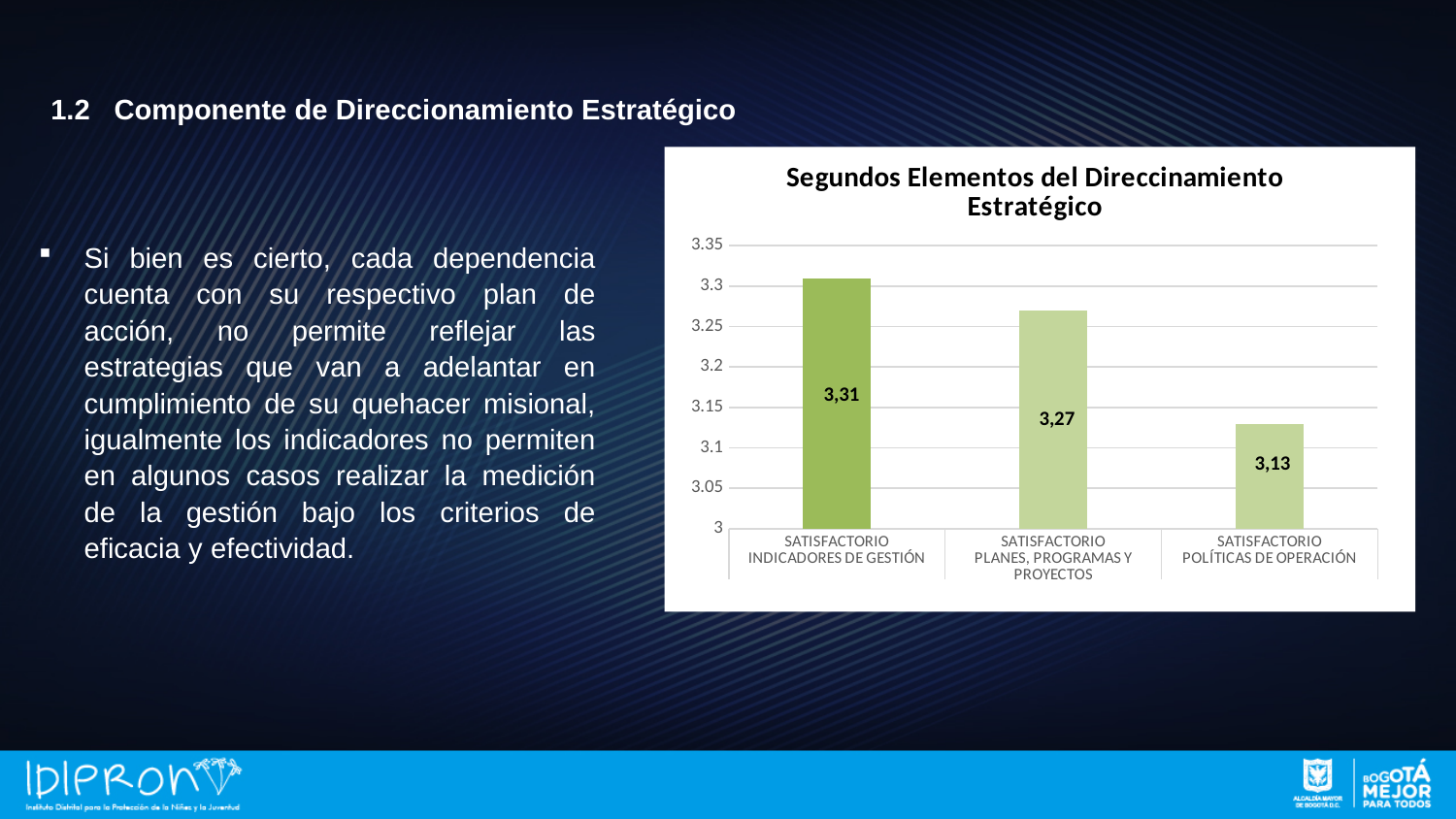
Which category has the highest value? SATISFACTORIO INDICADORES DE GESTIÓN What is the value for SATISFACTORIO POLÍTICAS DE OPERACIÓN? 3,13 Which is larger, the value for SATISFACTORIO INDICADORES DE GESTIÓN or the value for SATISFACTORIO PLANES, PROGRAMAS Y PROYECTOS? SATISFACTORIO INDICADORES DE GESTIÓN How many categories are shown in the chart? 3 What is the value for SATISFACTORIO INDICADORES DE GESTIÓN? 3,31 What kind of chart is shown on the slide? bar chart What is the difference between the values for SATISFACTORIO INDICADORES DE GESTIÓN and SATISFACTORIO POLÍTICAS DE OPERACIÓN? 0,18 What is the difference between the values for SATISFACTORIO PLANES, PROGRAMAS Y PROYECTOS and SATISFACTORIO POLÍTICAS DE OPERACIÓN? 0,14 What is the title of the chart? Segundos Elementos del Direccinamiento Estratégico Is the value for SATISFACTORIO POLÍTICAS DE OPERACIÓN greater or less than 3.2? less What is the value for SATISFACTORIO PLANES, PROGRAMAS Y PROYECTOS? 3,27 Which category has the lowest value? SATISFACTORIO POLÍTICAS DE OPERACIÓN